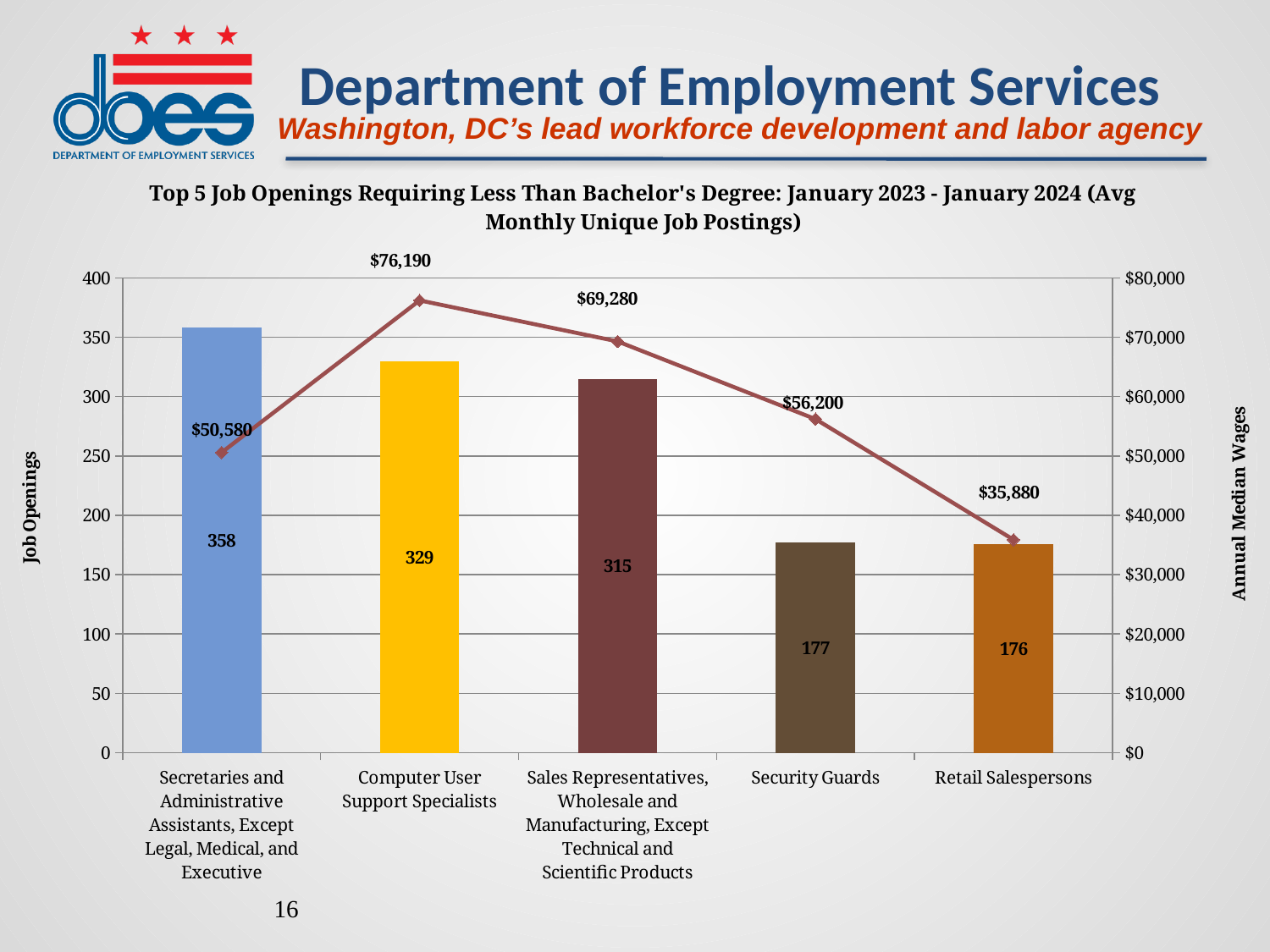
What is the difference in job openings between Secretaries and Administrative Assistants and Sales Representatives, Wholesale and Manufacturing? 43 How many job openings are shown for Computer User Support Specialists? 329 What is the label of the right-hand vertical axis? Annual Median Wages What is the annual median wage shown for Secretaries and Administrative Assistants, Except Legal, Medical, and Executive? $50,580 What kind of chart is used to show job openings? Bar chart What is the annual median wage shown for Security Guards? $56,200 How many occupations are shown on the chart? 5 Which occupation has the lowest annual median wage? Retail Salespersons What is the difference between the annual median wages of Computer User Support Specialists and Retail Salespersons? $40,310 Which occupation has the highest annual median wage? Computer User Support Specialists Which occupation has the highest number of job openings? Secretaries and Administrative Assistants, Except Legal, Medical, and Executive Which has more job openings, Sales Representatives, Wholesale and Manufacturing or Security Guards? Sales Representatives, Wholesale and Manufacturing